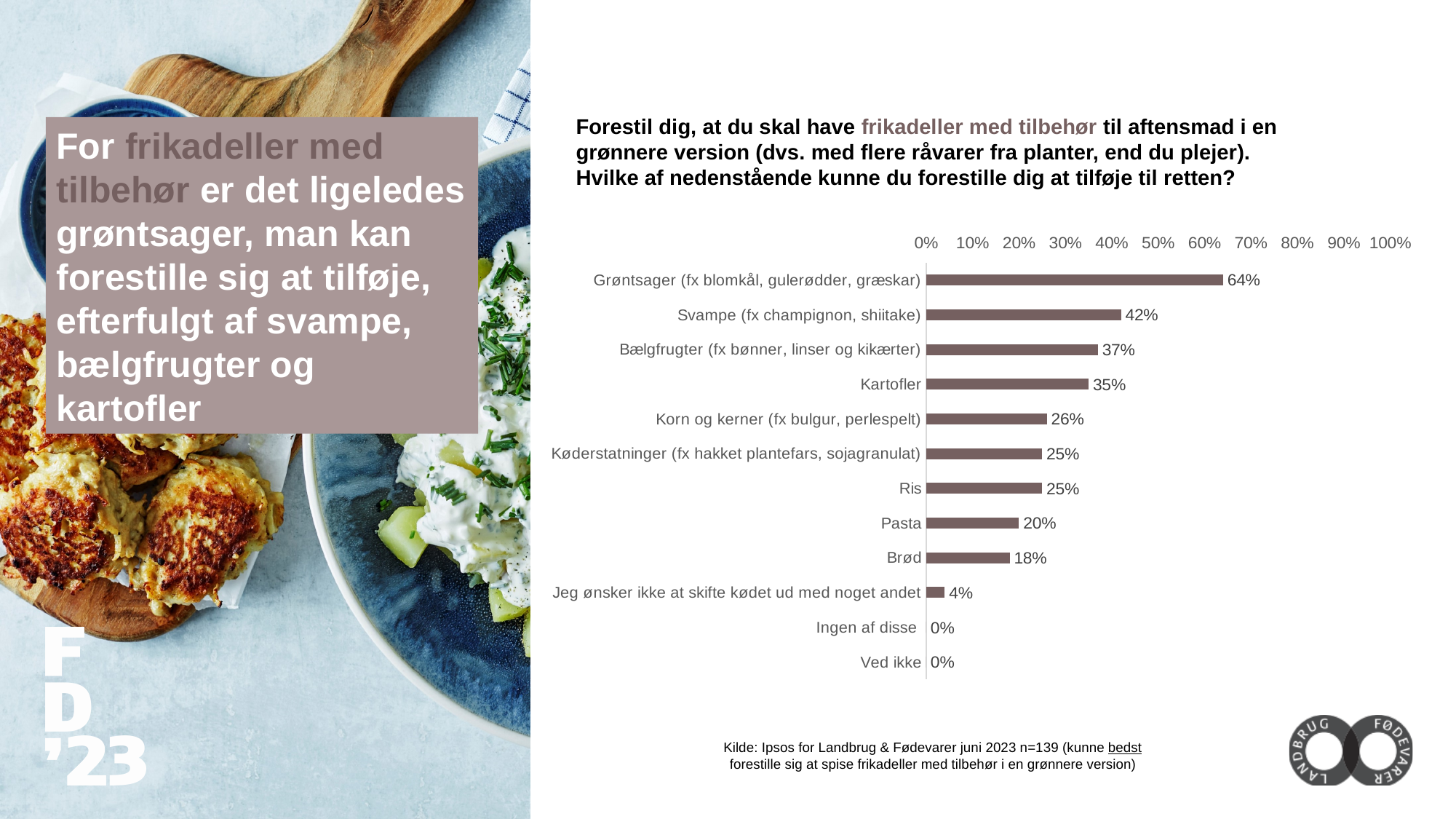
Which category has the highest value? Grøntsager (fx blomkål, gulerødder, græskar) What is the difference between the values for Pasta and Brød? 2% What is the value for Brød? 18% What is the value for Kartofler? 35% Is the value for Korn og kerner (fx bulgur, perlespelt) greater or less than 30%? less What is the difference between the values for Grøntsager (fx blomkål, gulerødder, græskar) and Svampe (fx champignon, shiitake)? 22% What kind of chart is shown on the slide? bar chart How many categories are shown in the chart? 12 What is the value for Jeg ønsker ikke at skifte kødet ud med noget andet? 4% Which is larger, the value for Bælgfrugter (fx bønner, linser og kikærter) or the value for Kartofler? Bælgfrugter (fx bønner, linser og kikærter) What is the highest value shown on the horizontal axis of the chart? 100% What is the value for Svampe (fx champignon, shiitake)? 42%